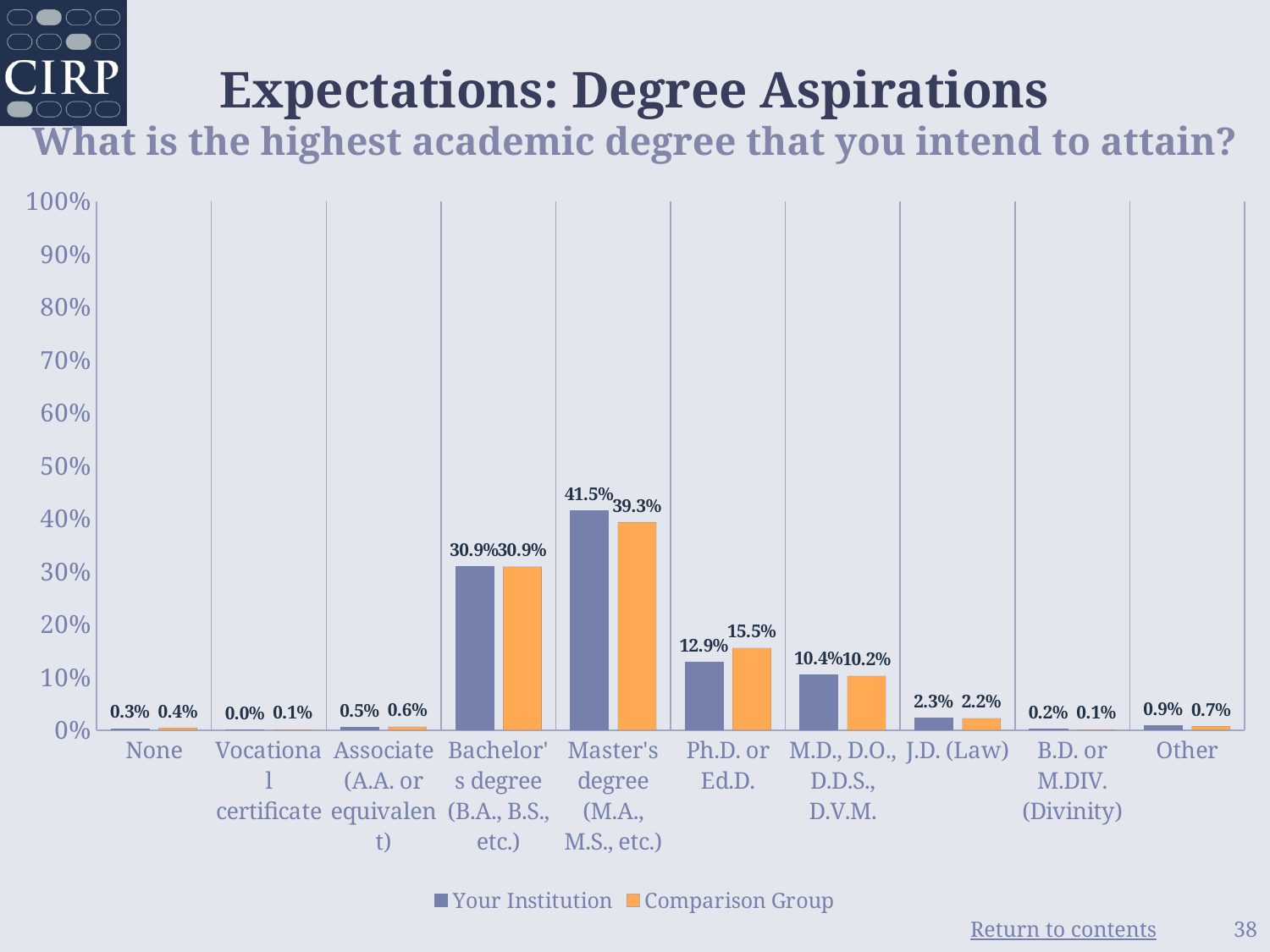
Which category has the highest value for Your Institution? Master's degree (M.A., M.S., etc.) How many series does the legend list? 2 Is the value for Your Institution for Bachelor's degree (B.A., B.S., etc.) greater or less than 40%? less What kind of chart is shown on the slide? bar chart Which category has the lowest value for Your Institution? Vocational certificate What is the value for Comparison Group for Ph.D. or Ed.D.? 15.5% What is the value for Your Institution for Master's degree (M.A., M.S., etc.)? 41.5% What is the value for Your Institution for J.D. (Law)? 2.3% Which is larger for M.D., D.O., D.D.S., D.V.M.: Your Institution or Comparison Group? Your Institution What is the difference between Your Institution and Comparison Group for Ph.D. or Ed.D.? 2.6% What is the difference between Your Institution and Comparison Group for Master's degree (M.A., M.S., etc.)? 2.2% How many categories are shown on the x axis? 10